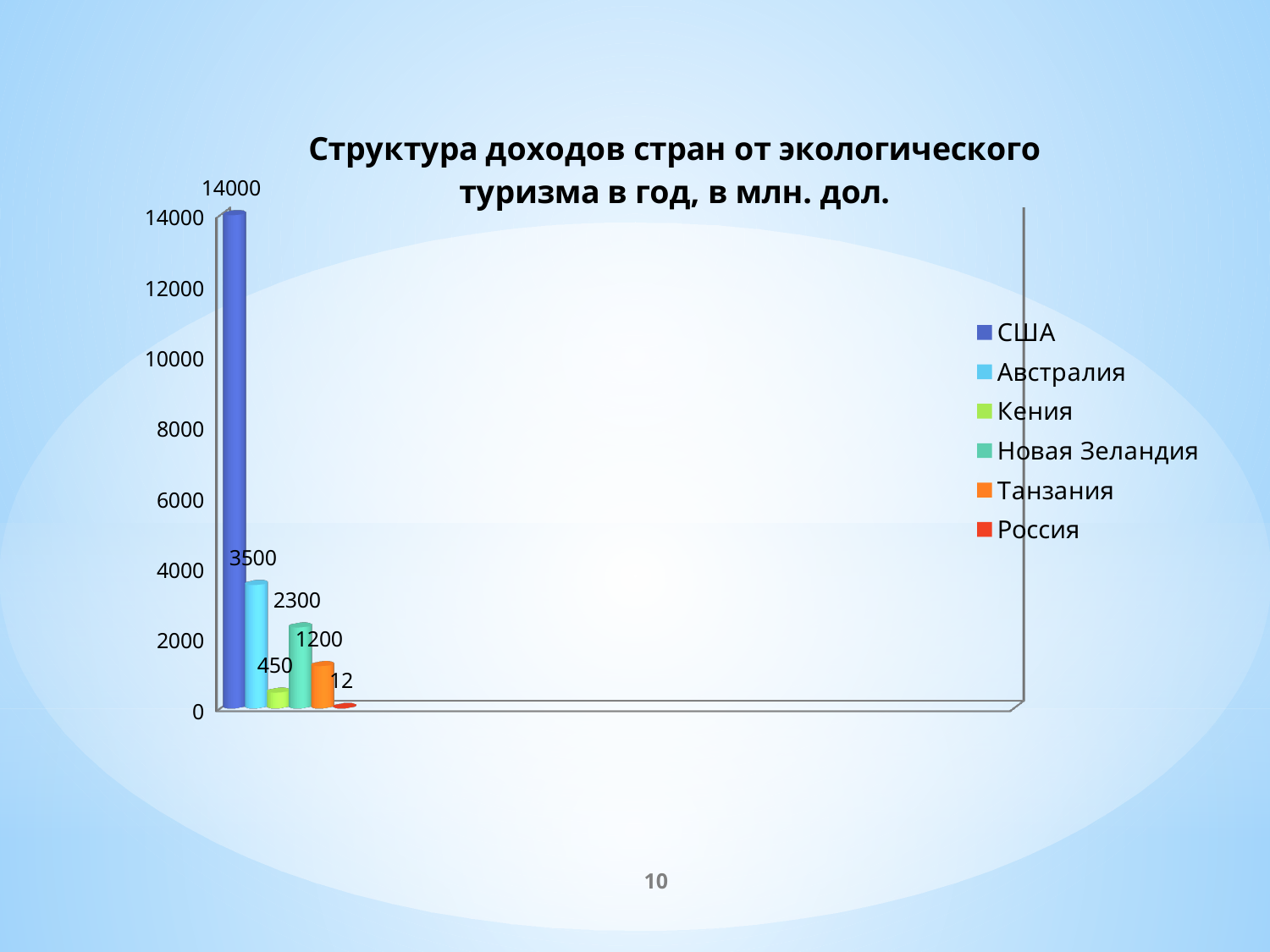
What is the value for Австралия? 3500 What is the value for Кения? 450 How many series does the legend list? 6 Which is larger, the value for Новая Зеландия or the value for Танзания? Новая Зеландия What is the difference between the values for США and Австралия? 10500 What is the value for Россия? 12 What is the value for Новая Зеландия? 2300 What is the value for США? 14000 Which country has the lowest value? Россия Which country has the highest value? США What kind of chart is shown on the slide? Bar chart What is the title of the chart? Структура доходов стран от экологического туризма в год, в млн. дол.